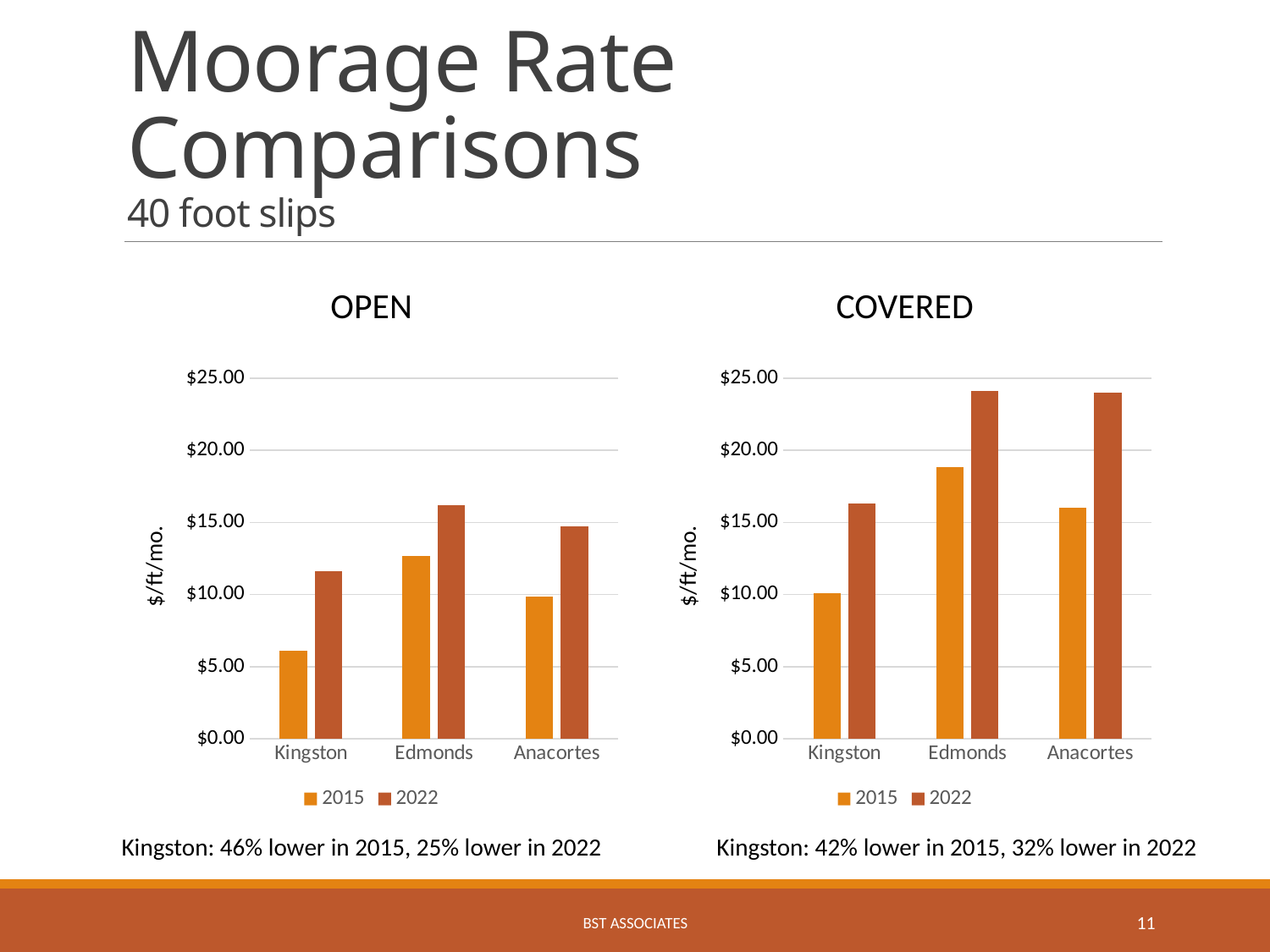
In the OPEN chart, which category has the highest 2022 value? Edmonds In the COVERED chart, which category has the lowest 2022 value? Kingston What kind of chart is the OPEN chart? bar chart In the OPEN chart, which is larger for Anacortes: the 2015 value or the 2022 value? 2022 In the COVERED chart, which is larger: the 2015 value for Kingston or the 2015 value for Anacortes? Anacortes In the OPEN chart, is the 2022 value for Kingston greater or less than $10.00? greater In the COVERED chart, is the 2015 value for Edmonds greater or less than $20.00? less In the OPEN chart, which category has the lowest 2015 value? Kingston How many categories are shown on the x axis of the COVERED chart? 3 How many series does the legend of the OPEN chart list? 2 What is the y-axis label on the COVERED chart? $/ft/mo. In the COVERED chart, which category has the highest 2015 value? Edmonds